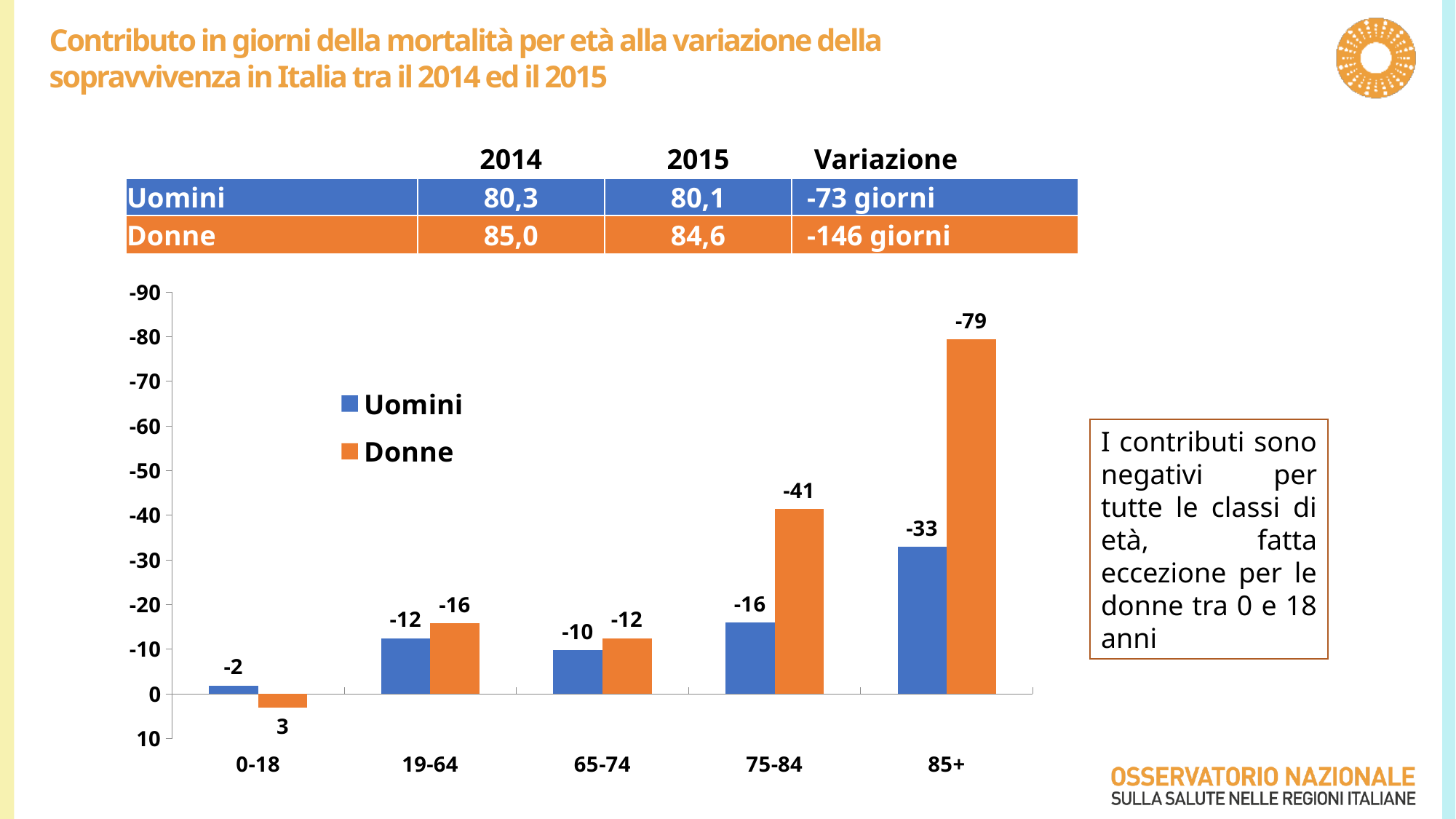
What is the value for Donne in the 85+ age group? -79 How many series does the chart legend list? 2 Which series is shown in orange in the chart? Donne What is the value for Donne in the 0-18 age group? 3 What kind of chart is shown on the slide? bar chart How many age categories are shown on the x axis of the chart? 5 In the 75-84 age group, which series has the larger negative value, Uomini or Donne? Donne What is the difference between the Donne and Uomini values in the 85+ age group? 46 Which age group has the smallest negative value for Uomini? 0-18 What is the value for Uomini in the 75-84 age group? -16 What is the value for Uomini in the 65-74 age group? -10 Which age group has the largest negative value for Donne? 85+